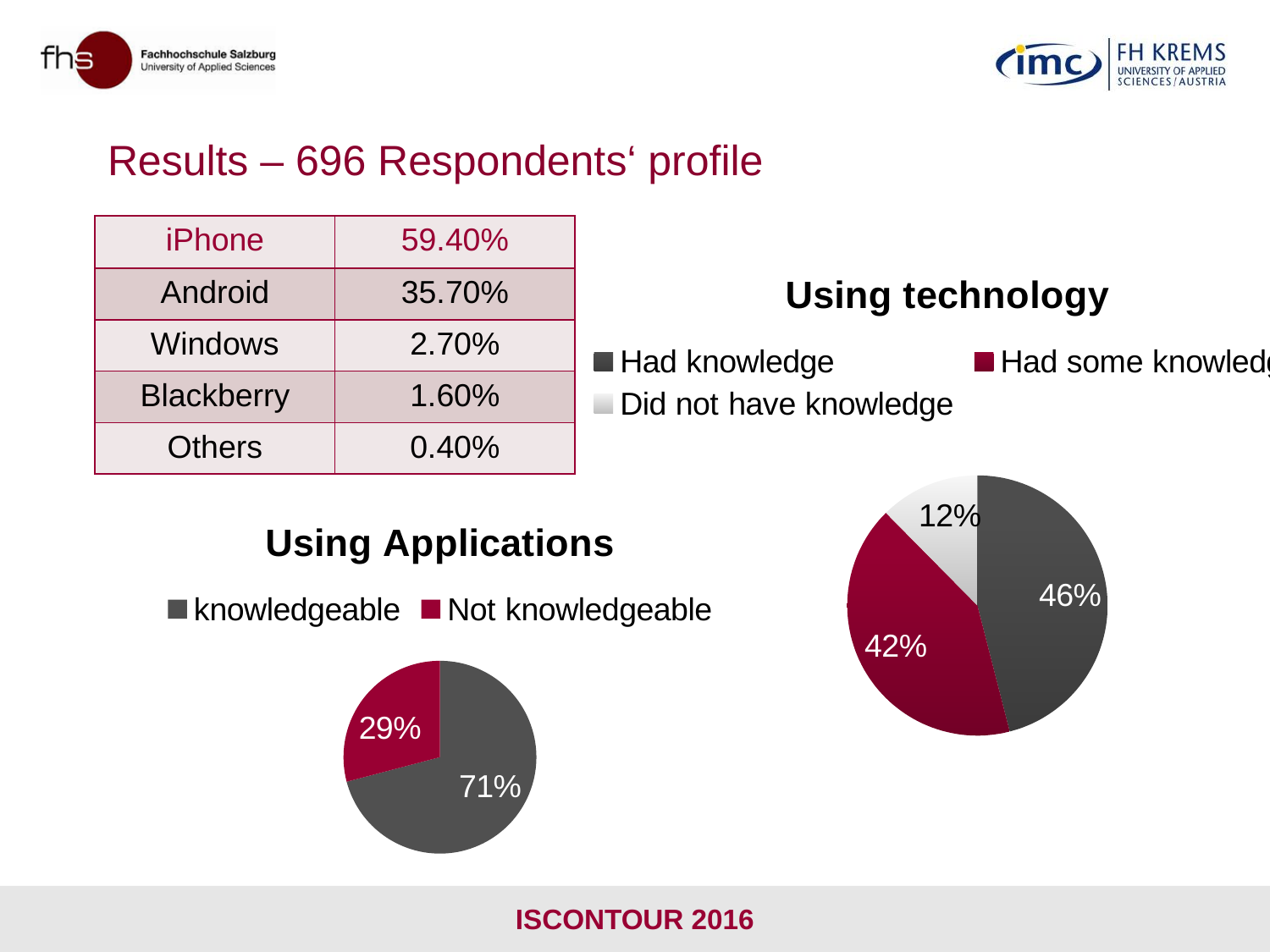
In the "Using technology" chart, which category has the largest slice? Had knowledge In the "Using technology" chart, what share of respondents Did not have knowledge? 12% In the "Using Applications" chart, what is the difference in percentage points between knowledgeable and Not knowledgeable? 42 In the "Using technology" chart, what is the difference in percentage points between Had knowledge and Did not have knowledge? 34 In the "Using technology" chart, what share of respondents Had knowledge? 46% What type of chart is the "Using Applications" chart? Pie chart In the "Using technology" chart, which category has the smallest slice? Did not have knowledge How many slices does the "Using technology" pie chart have? 3 How many entries does the legend of the "Using Applications" chart list? 2 In the "Using technology" chart, which is larger: Had knowledge or Had some knowledge? Had knowledge In the "Using Applications" chart, what share of respondents are knowledgeable? 71% In the "Using Applications" chart, what share of respondents are Not knowledgeable? 29%